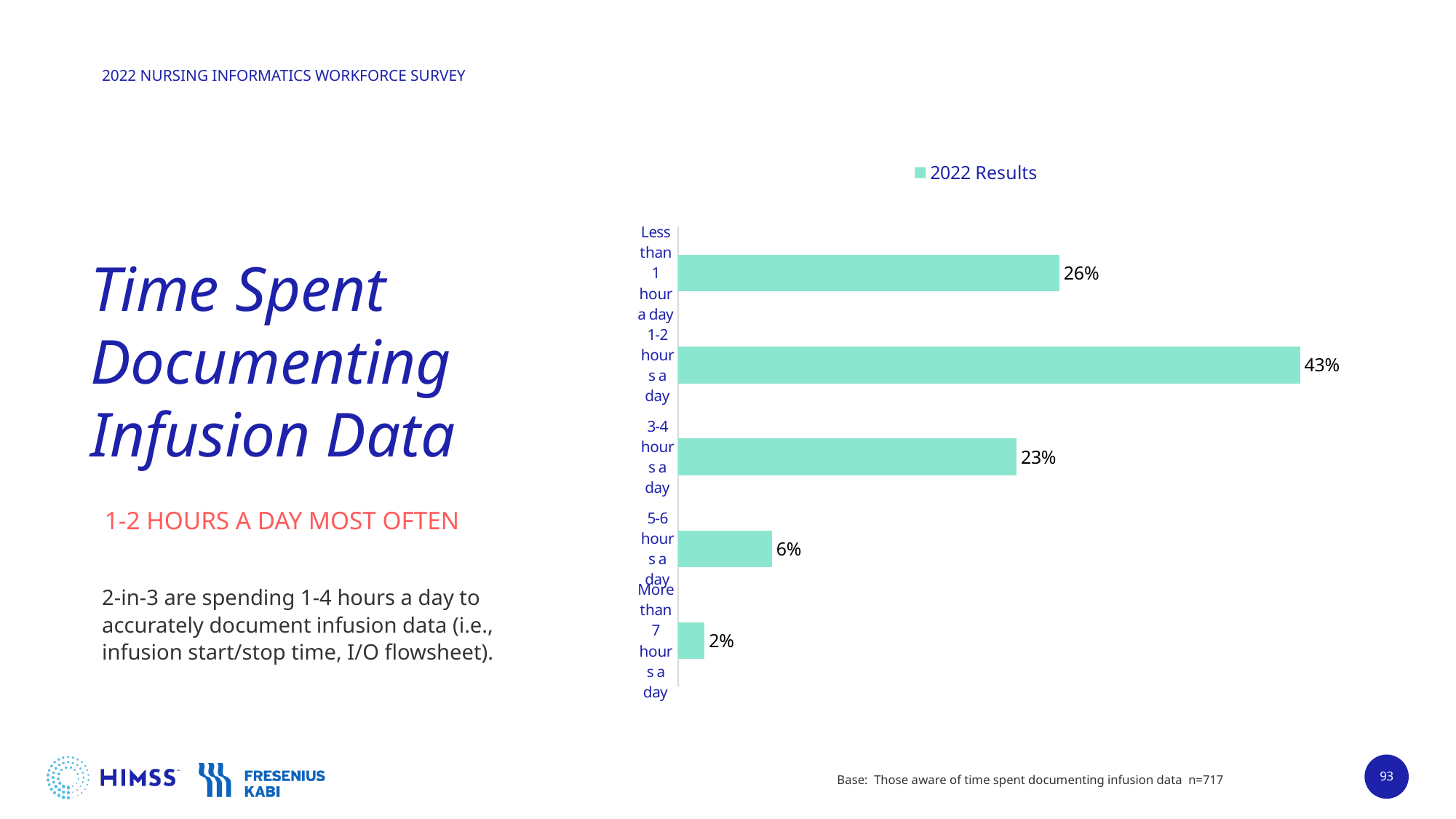
What kind of chart is shown on the slide? Bar chart What is the value for 3-4 hours a day? 23% Which category has the highest value? 1-2 hours a day What is the value for more than 7 hours a day? 2% What is the difference between the values for 1-2 hours a day and 3-4 hours a day? 20% How many series does the legend list? 1 How many categories are shown in the chart? 5 What is the legend entry for the series shown in the chart? 2022 Results What percentage of respondents spend less than 1 hour a day documenting infusion data? 26% What percentage of respondents spend 1-2 hours a day documenting infusion data? 43% Which category has the lowest value? More than 7 hours a day Which is larger, the value for less than 1 hour a day or the value for 5-6 hours a day? Less than 1 hour a day